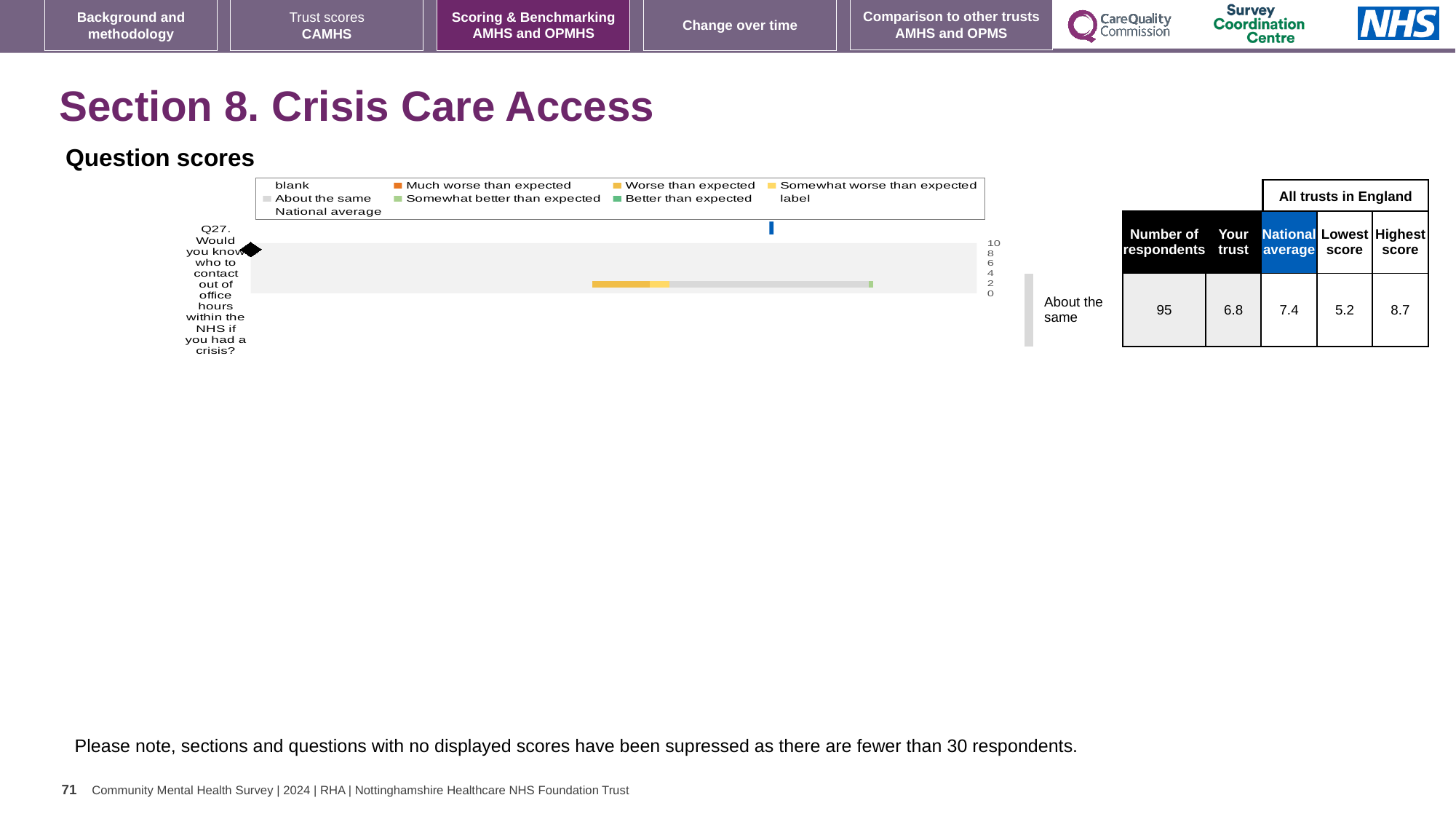
What kind of chart is used to show the question scores for Section 8? bar chart What is the maximum value shown on the score axis of the Question scores chart? 10 How many respondents answered Q27? 95 Which is larger for Q27, the 'Your trust' score or the national average? National average What is the national average score for Q27? 7.4 Which question is shown in the Question scores chart? Q27. Would you know who to contact out of office hours within the NHS if you had a crisis? What is the lowest score among all trusts in England for Q27? 5.2 How many questions are plotted in the Question scores chart? 1 What is the difference between the highest and lowest scores for Q27 across all trusts in England? 3.5 What is the 'Your trust' score for Q27? 6.8 What benchmark category is shown for Q27 next to the chart? About the same What is the highest score among all trusts in England for Q27? 8.7